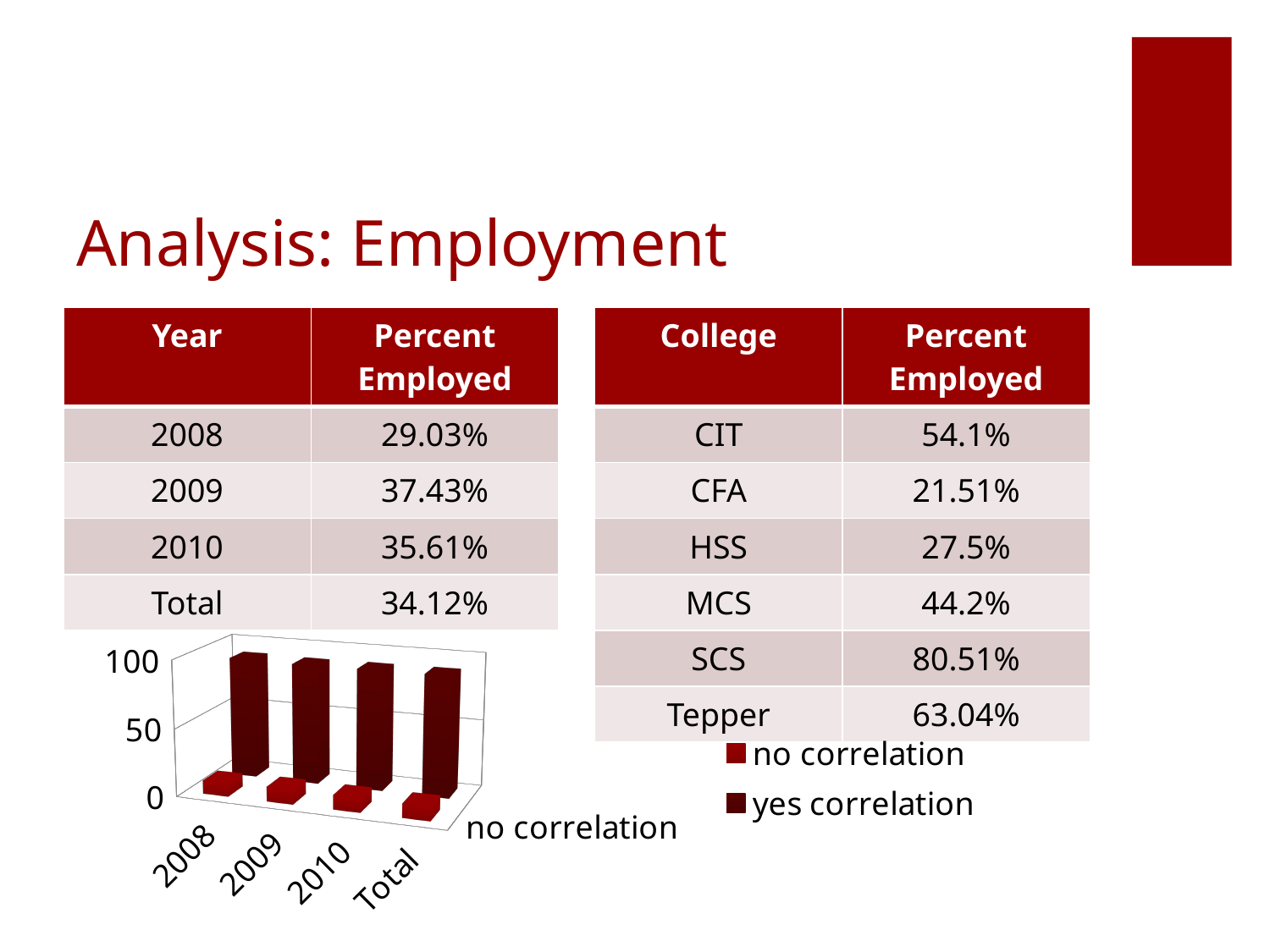
What kind of chart is shown on the slide? bar chart In 2009, which series has the larger value, 'no correlation' or 'yes correlation'? yes correlation How many categories are shown along the x axis of the chart? 4 What is the highest tick value shown on the chart's vertical axis? 100 Is the value for 'yes correlation' in 2008 greater or less than 50? greater Is the value for 'yes correlation' for Total greater or less than 50? greater What are the two series named in the chart's legend? no correlation, yes correlation Which category label appears last along the x axis of the chart? Total Is the value for 'no correlation' in 2010 greater or less than 50? less How many series does the chart's legend list? 2 For Total, which series has the smaller value, 'no correlation' or 'yes correlation'? no correlation